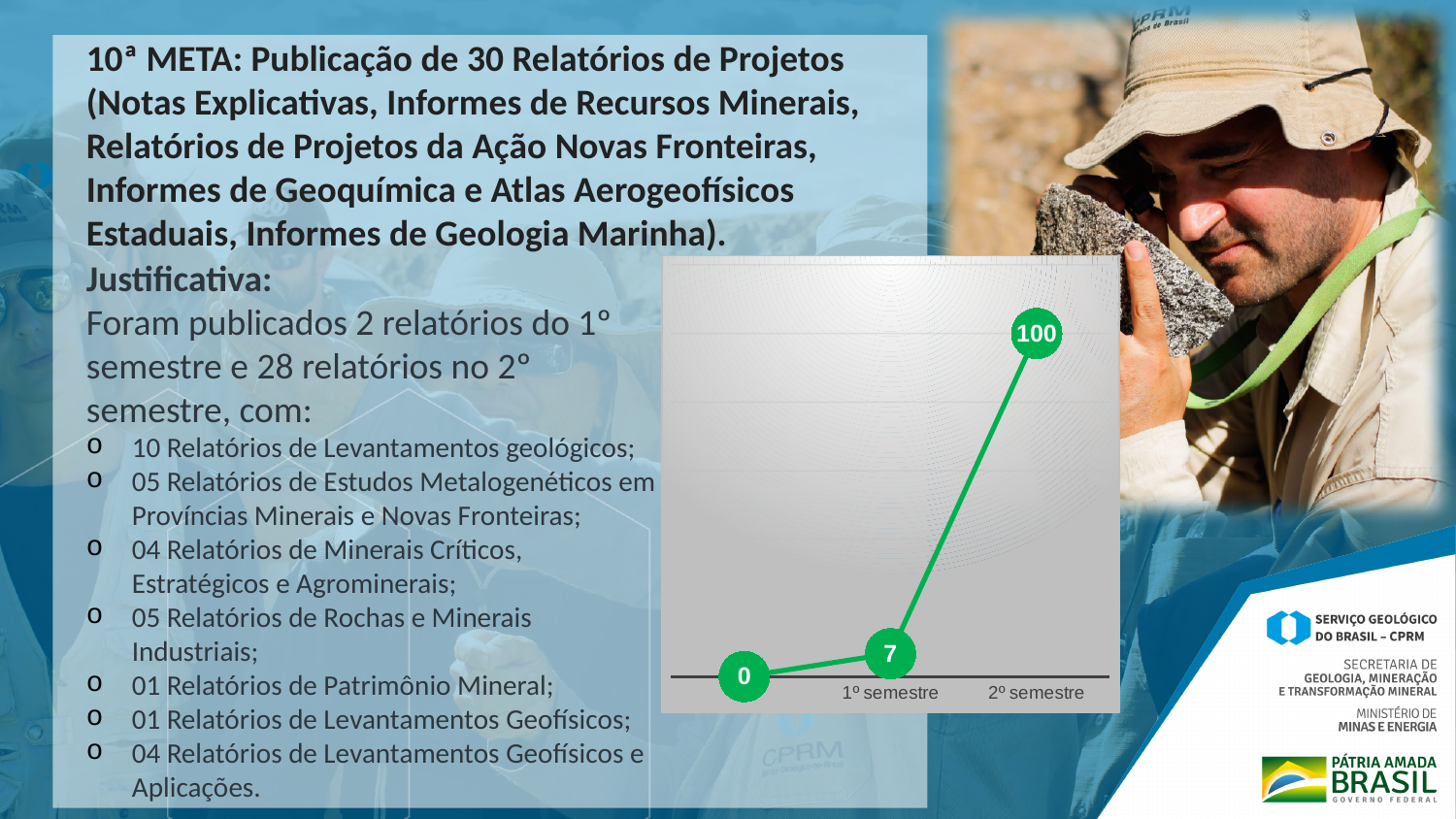
Is the value for 2º semestre larger or smaller than the value for 1º semestre? larger Which of the two labelled categories, 1º semestre or 2º semestre, has the lower value? 1º semestre Do the values rise or fall from left to right along the x axis? rise What kind of chart is shown on the slide? line chart Which category has the highest value on the chart? 2º semestre What is the difference between the values for 2º semestre and 1º semestre? 93 What is the value plotted for 1º semestre? 7 What is the value of the leftmost data point on the line? 0 How many data points are plotted on the line? 3 What is the total of the three data labels shown on the line? 107 What is the value plotted for 2º semestre? 100 What colour is the line on the chart? green